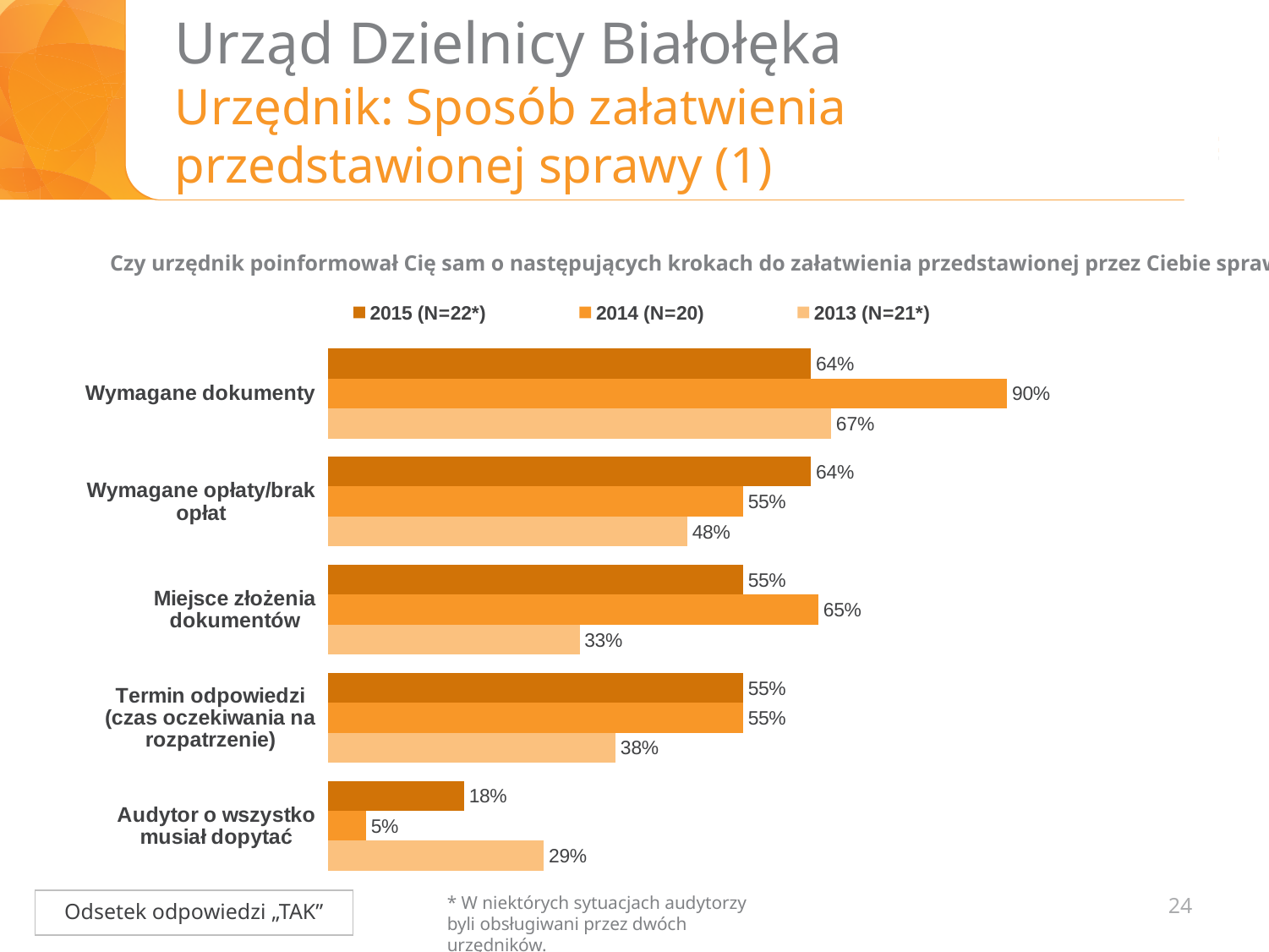
How many categories are shown on the chart? 5 What is the difference between the 2013 (N=21*) and 2014 (N=20) values for "Audytor o wszystko musiał dopytać"? 24% What is the value for "Audytor o wszystko musiał dopytać" in the 2015 (N=22*) series? 18% Which category has the lowest value in the 2015 (N=22*) series? Audytor o wszystko musiał dopytać What is the difference between the 2014 (N=20) and 2015 (N=22*) values for "Wymagane dokumenty"? 26% Which category has the highest value in the 2014 (N=20) series? Wymagane dokumenty What is the value for "Wymagane dokumenty" in the 2014 (N=20) series? 90% Which series is shown in the lightest orange colour in the legend? 2013 (N=21*) What is the value for "Miejsce złożenia dokumentów" in the 2013 (N=21*) series? 33% How many series does the legend list? 3 Which is larger for "Wymagane opłaty/brak opłat": the 2015 (N=22*) value or the 2013 (N=21*) value? 2015 (N=22*) What kind of chart is shown on the slide? bar chart